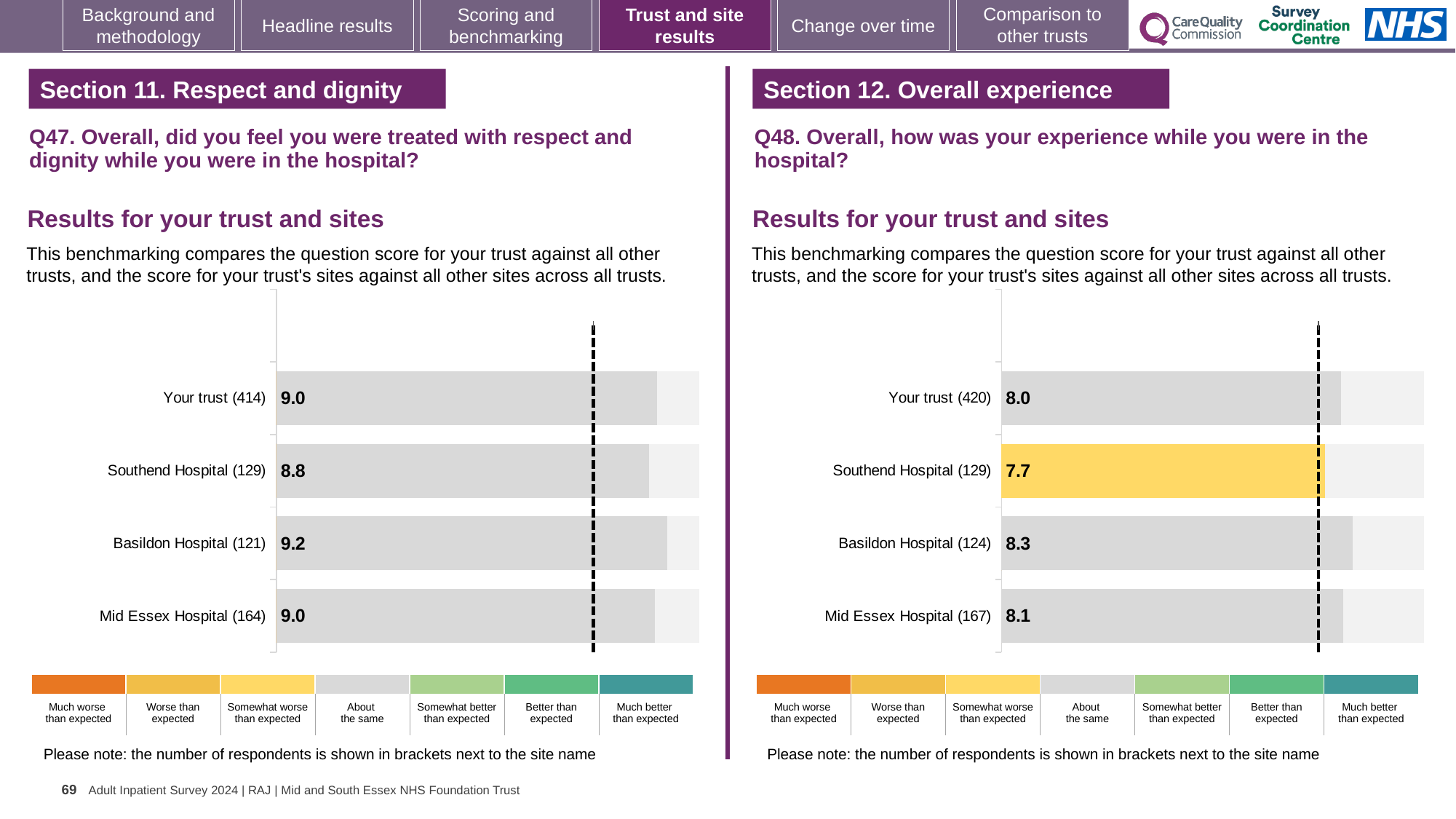
How many bars are plotted in the Q47 chart on the left? 4 In the Q48 chart on the right, what is the score for Your trust? 8.0 In the Q48 chart on the right, which site or trust has the lowest score? Southend Hospital In the Q48 chart on the right, which bar is coloured yellow rather than grey? Southend Hospital In the Q48 chart on the right, how many respondents are shown in brackets for Mid Essex Hospital? 167 In the Q47 chart on the left, which site or trust has the highest score? Basildon Hospital What kind of chart is used for the Q48 results on the right? Bar chart In the Q47 chart on the left, what is the score for Basildon Hospital? 9.2 In the Q47 chart on the left, which has the higher score, Southend Hospital or Mid Essex Hospital? Mid Essex Hospital In the Q48 chart on the right, what is the difference between the scores for Basildon Hospital and Southend Hospital? 0.6 In the Q48 chart on the right, what is the score for Southend Hospital? 7.7 In the Q47 chart on the left, what is the difference between the scores for Basildon Hospital and Southend Hospital? 0.4